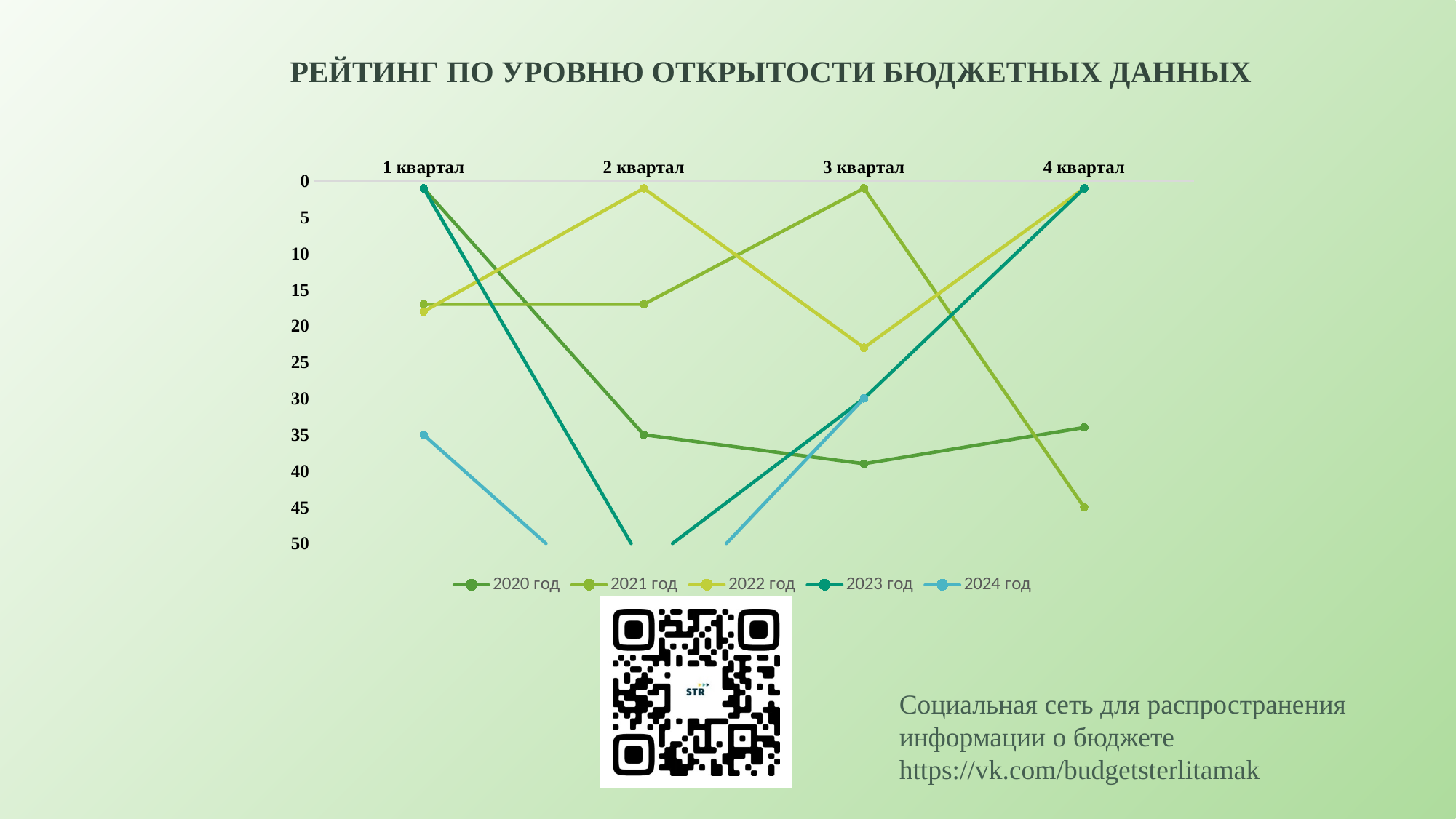
Is the value for 2021 год in 1 квартал greater or less than 20? less Which series is shown in light blue in the legend? 2024 год What is the title of the chart? РЕЙТИНГ ПО УРОВНЮ ОТКРЫТОСТИ БЮДЖЕТНЫХ ДАННЫХ Is the value for 2020 год in 2 квартал greater or less than 30? greater Is the value for 2024 год in 1 квартал greater or less than 30? greater How many quarters (categories) are shown on the x axis? 4 How many series does the legend list? 5 What kind of chart is shown on the slide? line chart